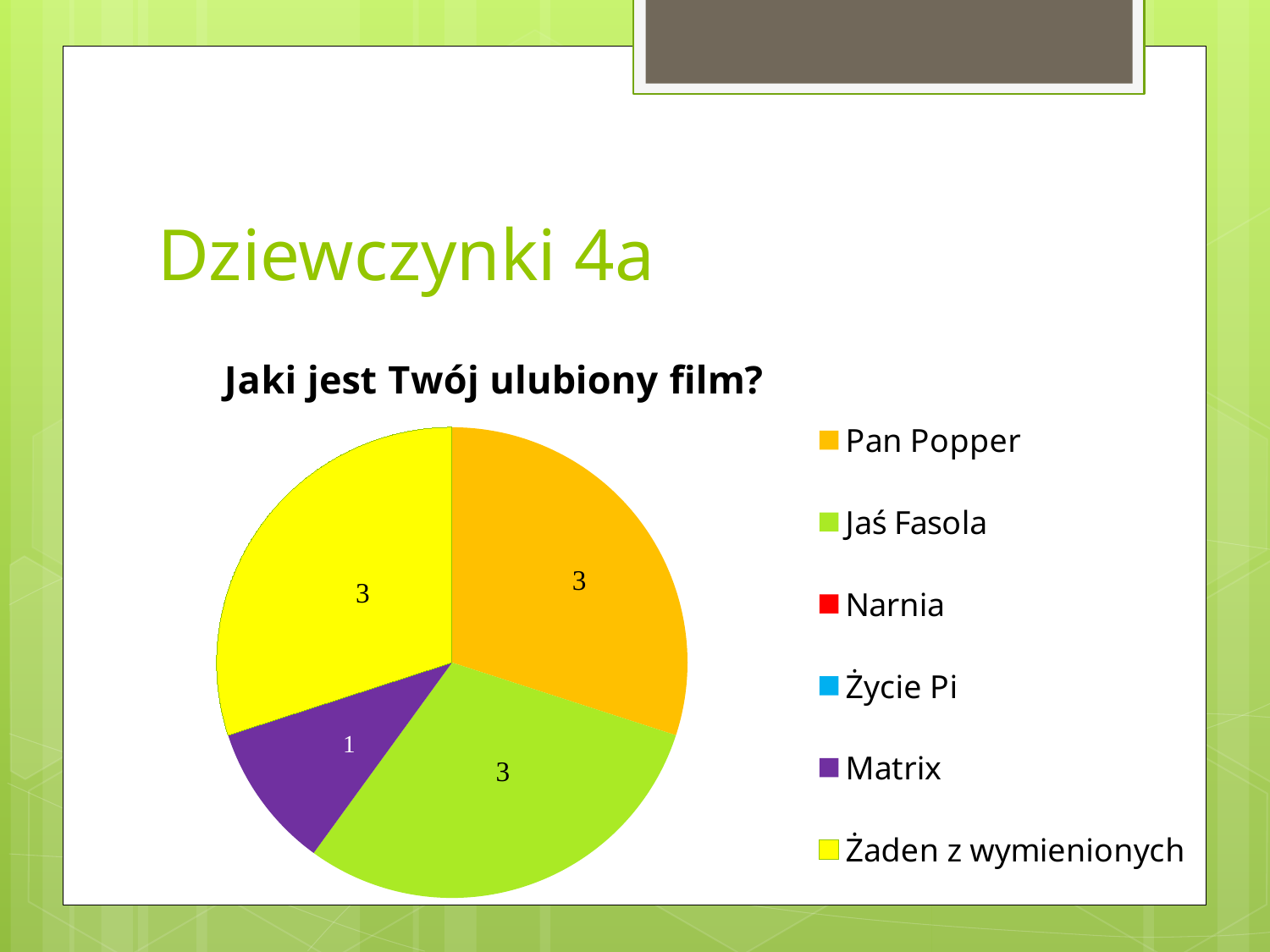
What is the total of all the values labelled on the pie? 10 What is the value shown for Pan Popper? 3 What is the value shown for Żaden z wymienionych? 3 Which of the slices drawn in the pie is the smallest? Matrix What is the title of the chart? Jaki jest Twój ulubiony film? Which is larger, the value for Pan Popper or the value for Matrix? Pan Popper What is the value shown for Matrix? 1 How many entries does the chart legend list? 6 What is the difference between the value for Jaś Fasola and the value for Matrix? 2 What type of chart is shown on the slide? pie chart What is the value shown for Jaś Fasola? 3 What share of the pie does the Matrix slice represent? 10%